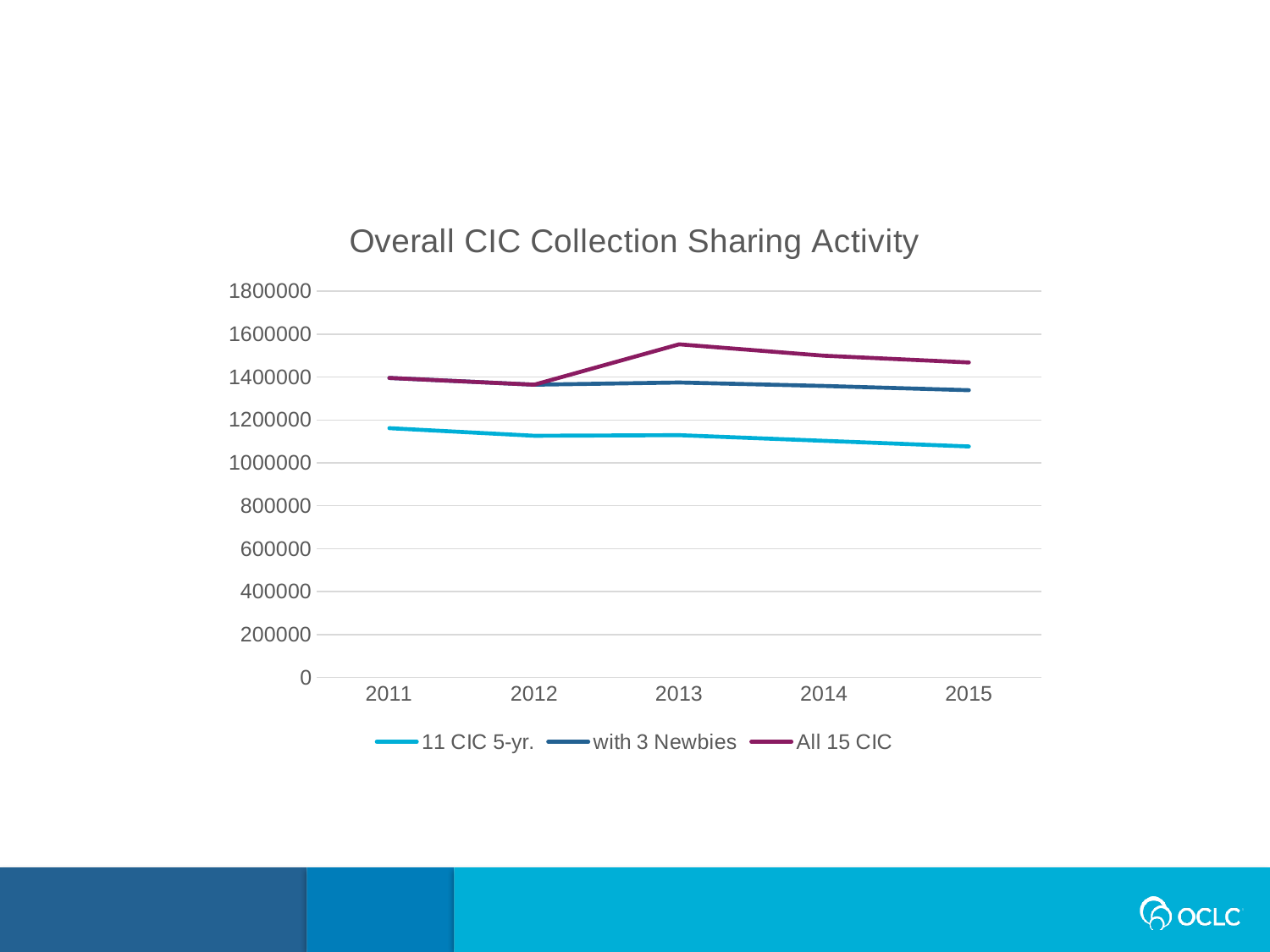
In which year is the 11 CIC 5-yr. series at its lowest? 2015 In 2014, which series has the larger value: All 15 CIC or with 3 Newbies? All 15 CIC In which year is the All 15 CIC series at its highest? 2013 Does the 11 CIC 5-yr. series rise or fall from 2011 to 2015? fall Is the value for 11 CIC 5-yr. in 2015 greater or less than 1200000? less Is the value for 11 CIC 5-yr. in 2011 greater or less than 1000000? greater Is the value for All 15 CIC in 2013 greater or less than 1400000? greater What kind of chart is shown on the slide? line chart What is the title of the chart? Overall CIC Collection Sharing Activity How many series does the legend list? 3 How many years are plotted along the x axis? 5